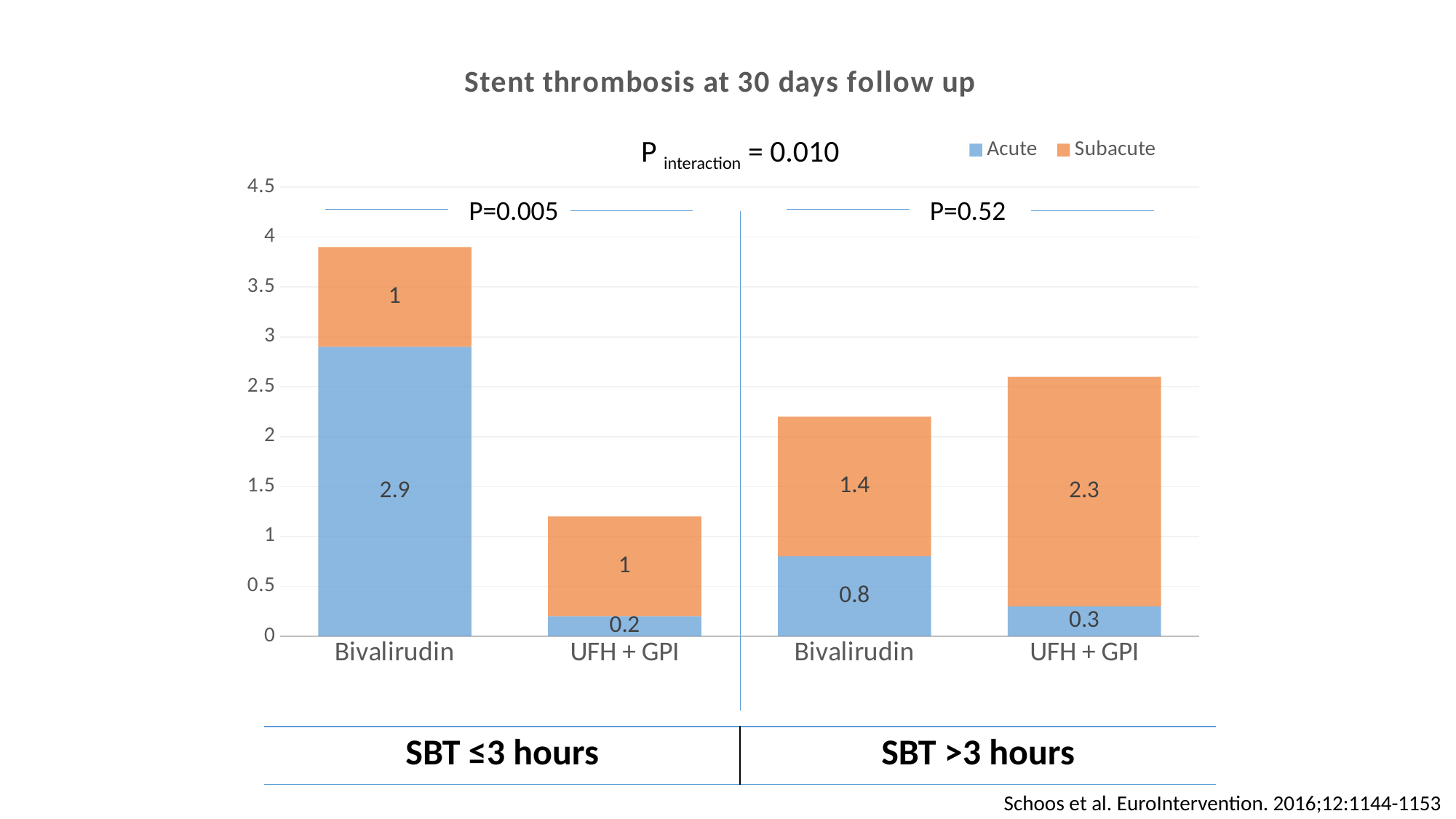
What is the total stacked value for Bivalirudin in the SBT ≤3 hours group? 3.9 What is the Acute value for Bivalirudin in the SBT ≤3 hours group? 2.9 How many series does the legend list? 2 What is the Subacute value for Bivalirudin in the SBT >3 hours group? 1.4 What is the title of the chart? Stent thrombosis at 30 days follow up What is the total stacked value for UFH + GPI in the SBT >3 hours group? 2.6 What is the Subacute value for UFH + GPI in the SBT >3 hours group? 2.3 What is the difference between the Subacute values for UFH + GPI in the SBT >3 hours group and Bivalirudin in the SBT >3 hours group? 0.9 Which bar has the highest Acute value? Bivalirudin (SBT ≤3 hours) Which bar has the lowest Acute value? UFH + GPI (SBT ≤3 hours) Which is larger: the Acute value for Bivalirudin in the SBT >3 hours group or the Acute value for UFH + GPI in the SBT >3 hours group? Bivalirudin (SBT >3 hours) What is the Acute value for UFH + GPI in the SBT ≤3 hours group? 0.2